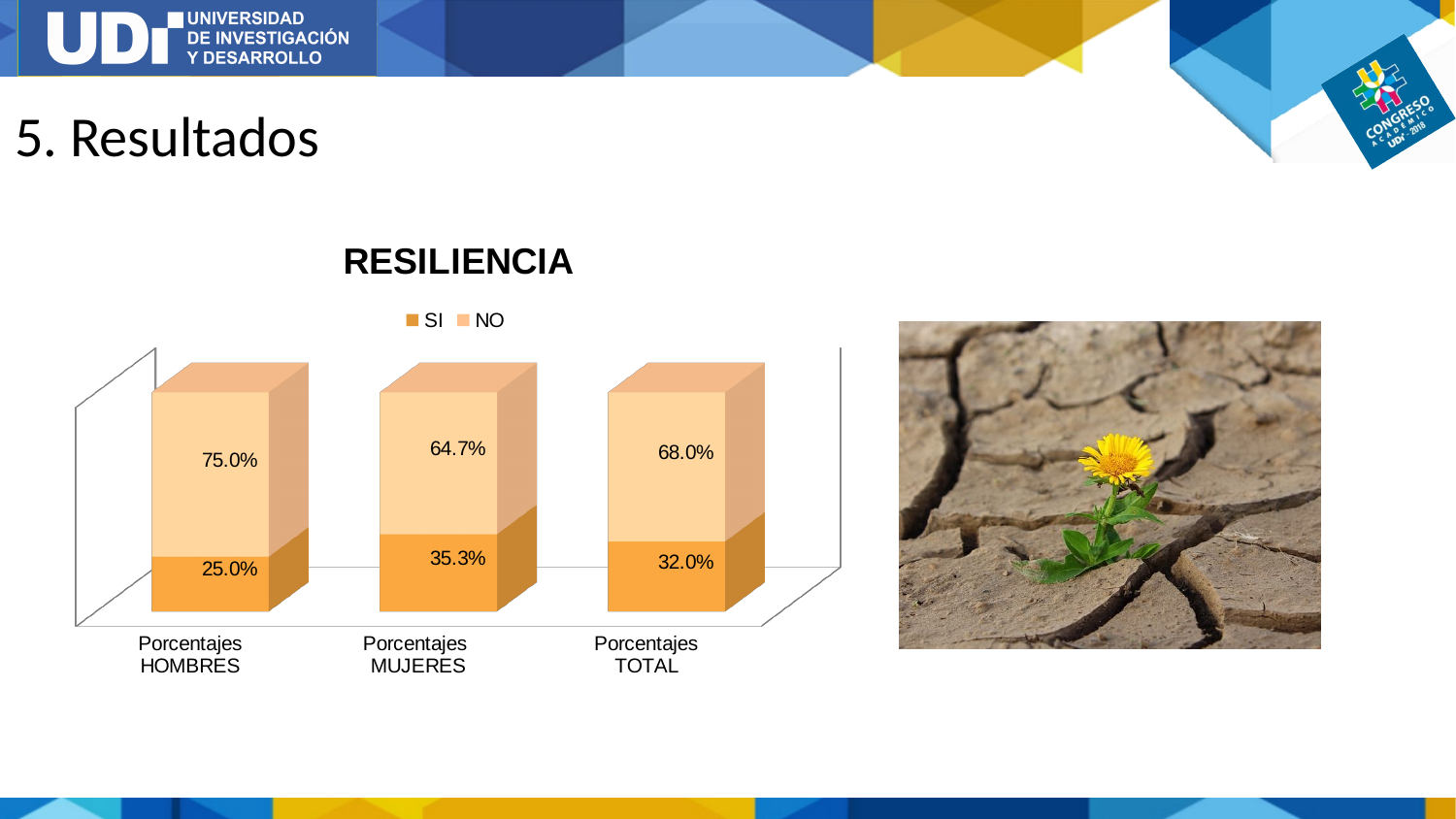
What is the title of the chart? RESILIENCIA What is the NO value for Porcentajes MUJERES? 64.7% What is the total of the stacked bar for Porcentajes HOMBRES? 100.0% How many series does the legend list? 2 Which category has the highest SI value? Porcentajes MUJERES Which category has the lowest NO value? Porcentajes MUJERES Which is larger: the SI value for Porcentajes MUJERES or the SI value for Porcentajes TOTAL? Porcentajes MUJERES What is the SI value for Porcentajes HOMBRES? 25.0% How many categories are shown on the x axis? 3 What is the SI value for Porcentajes TOTAL? 32.0% What is the difference between the NO values for Porcentajes HOMBRES and Porcentajes TOTAL? 7.0% What kind of chart is shown on the slide? Stacked bar chart